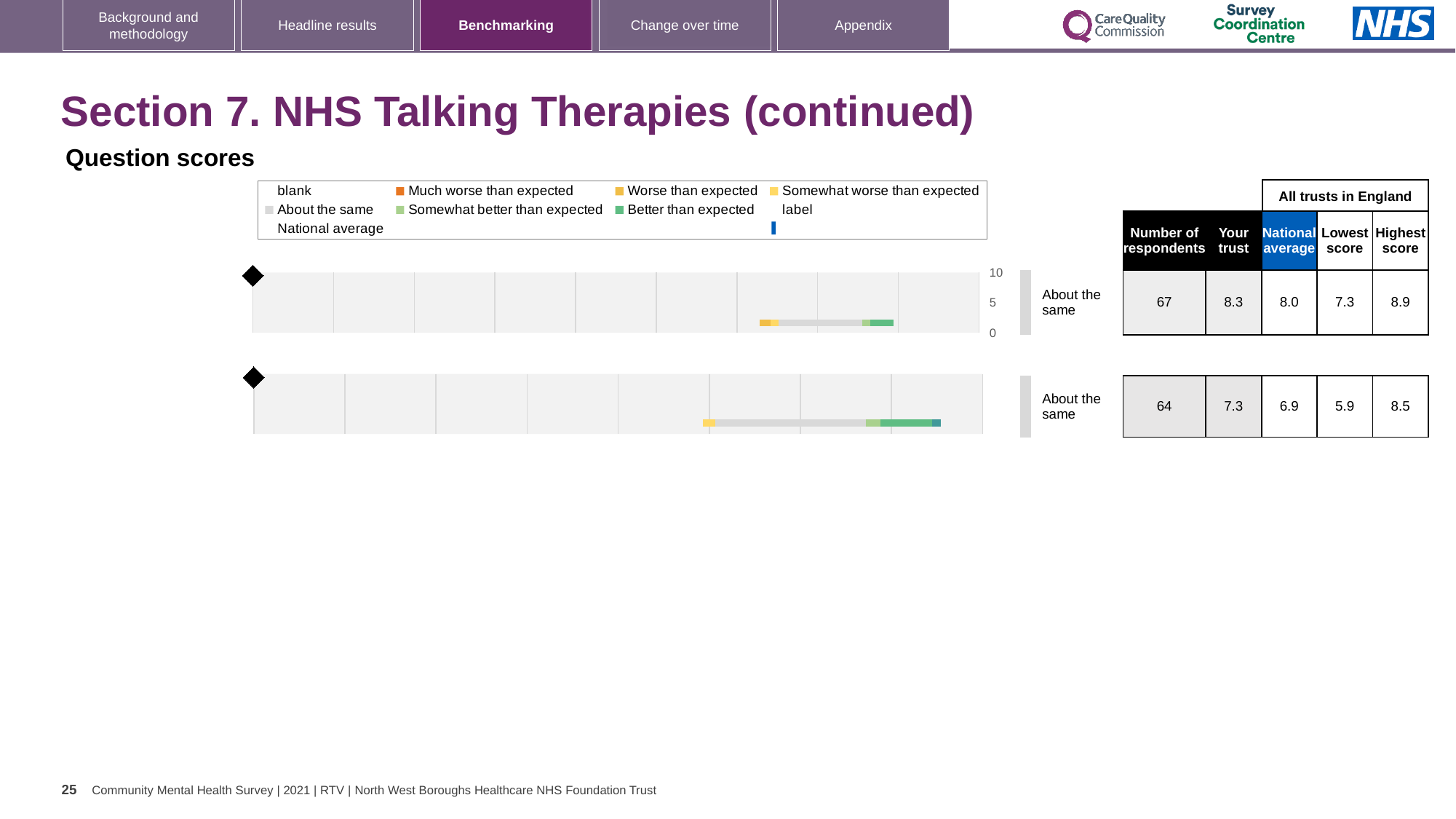
What kind of chart is used on this slide to show the question scores? bar chart For the top chart, what is the national average score? 8.0 Which chart has the higher 'Your trust' score, the top chart or the bottom chart? top chart For the top chart, what is the 'Your trust' score shown in the table? 8.3 For the top chart, is the 'Your trust' score higher or lower than the national average? higher What benchmark category label is shown next to both charts? About the same For the bottom chart, how much higher is the 'Your trust' score than the national average? 0.4 For the bottom chart, how many respondents are listed? 64 For the bottom chart, what is the lowest score among all trusts in England? 5.9 For the top chart, what is the difference between the highest score and the lowest score among all trusts in England? 1.6 What is the maximum value shown on the score axis of the top chart? 10 How many benchmarking charts are shown on the slide? 2